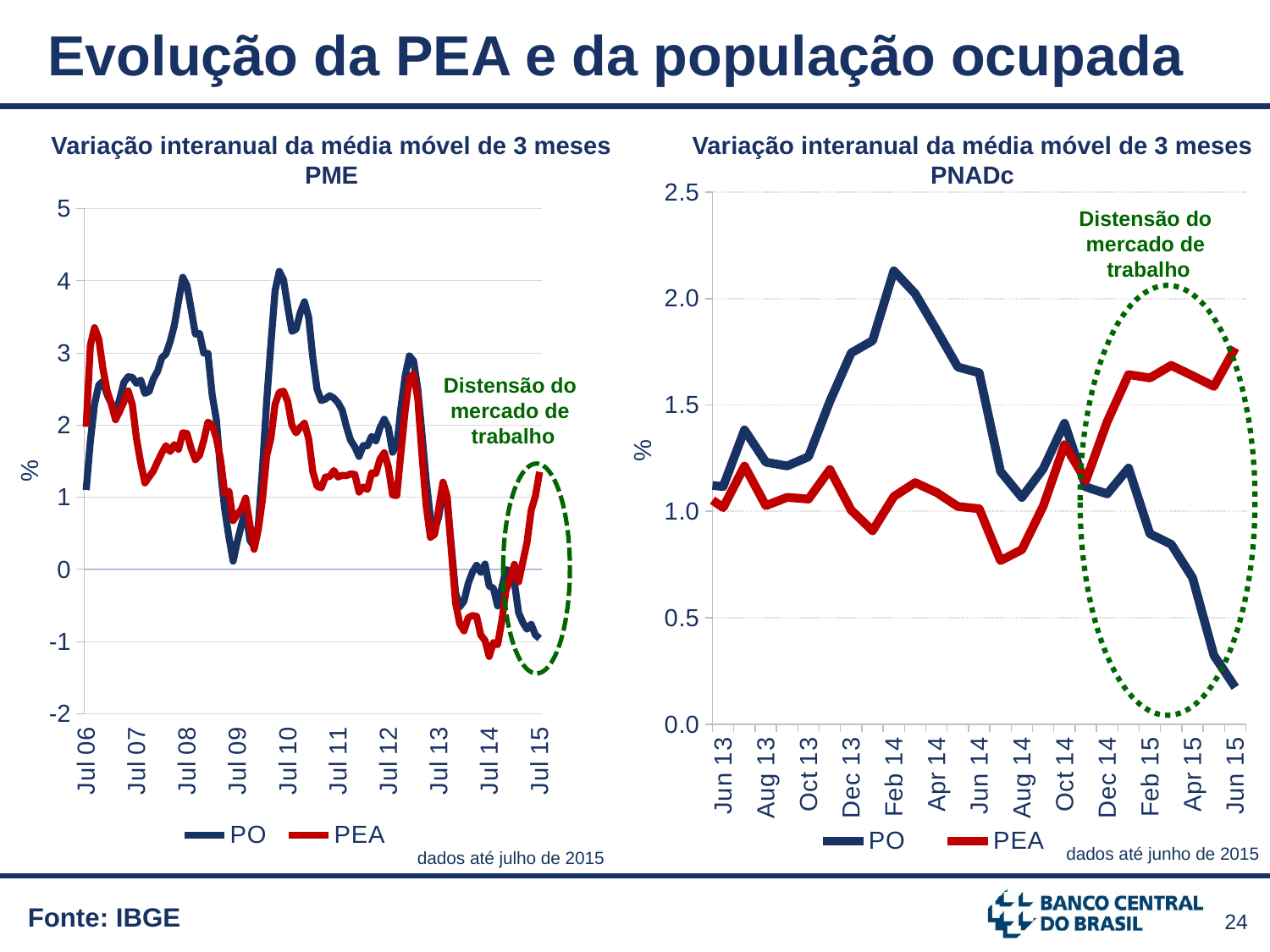
In the right chart (PNADc), does the PO line rise or fall between Oct 14 and Jun 15? fall In the right chart (PNADc), which series has the larger value at Feb 14, PO or PEA? PO What kind of chart is the left chart titled 'Variação interanual da média móvel de 3 meses PME'? line chart What kind of chart is the right chart titled 'Variação interanual da média móvel de 3 meses PNADc'? line chart In the left chart (PME), what are the two series named in the legend? PO and PEA In the left chart (PME), is the value of PO at Jul 15 greater or less than 0? less In the right chart (PNADc), is the value of PEA at Jun 15 greater or less than 1.5? greater In the right chart (PNADc), which series has the larger value at Jun 15, PO or PEA? PEA In the right chart (PNADc), is the value of PO at Jun 15 greater or less than 0.5? less In the right chart (PNADc), which colour is used for the PEA line? red In the right chart (PNADc), how many series does the legend list? 2